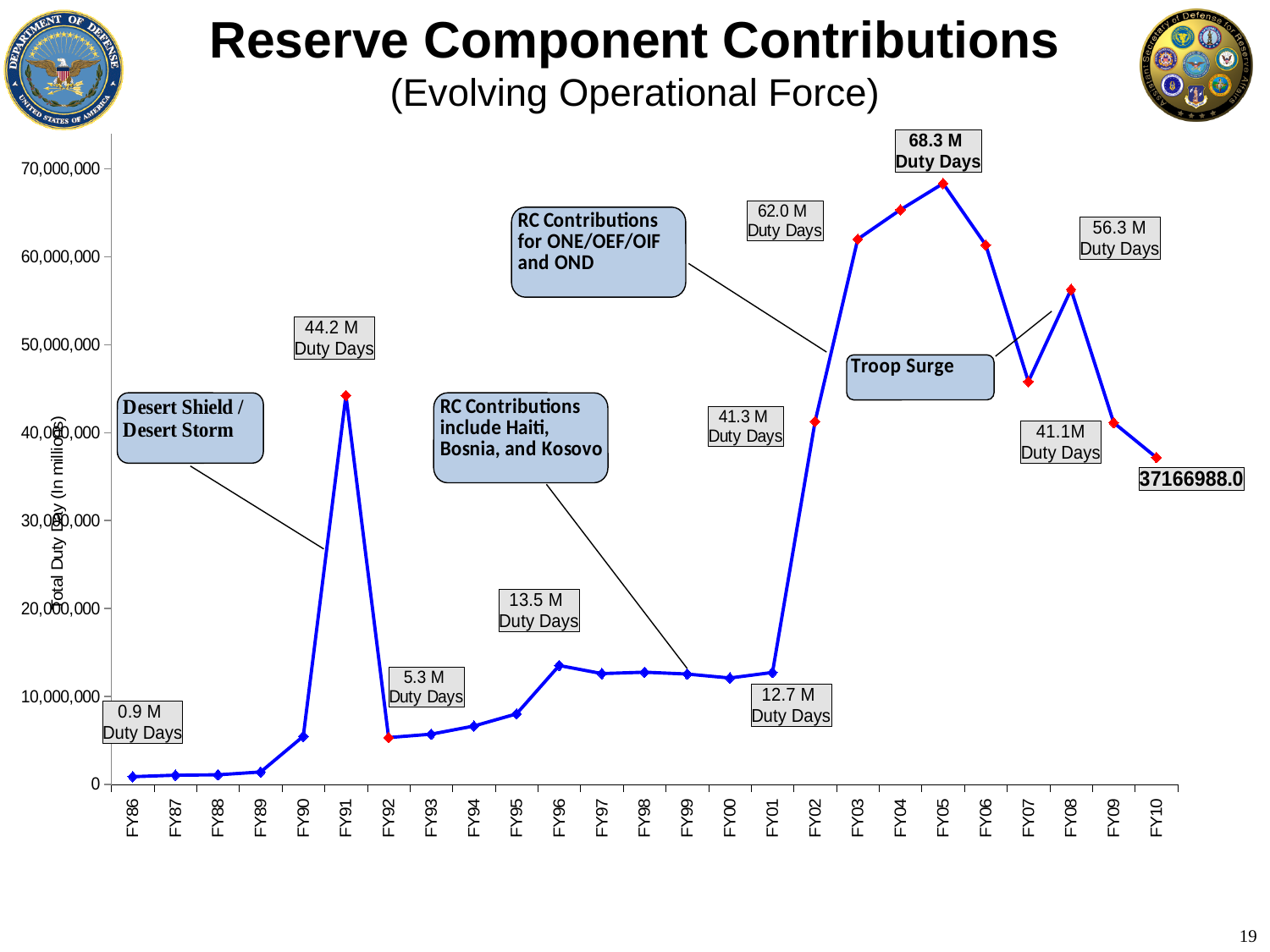
What is the value labelled for FY91? 44.2 M Duty Days How many fiscal years are plotted on the x axis? 25 What is the value labelled for FY08? 56.3 M Duty Days Which is larger, the value for FY91 or the value for FY02? FY91 What is the value labelled for FY05? 68.3 M Duty Days What is the value labelled for FY10? 37166988.0 Which event annotation is attached to the FY91 peak? Desert Shield / Desert Storm What kind of chart is shown on the slide? line chart Is the value for FY03 greater or less than 60,000,000? greater What is the difference between the labelled values for FY05 and FY03? 6.3 M Duty Days Is the value for FY07 greater or less than 50,000,000? less Which fiscal year has the highest total duty days? FY05